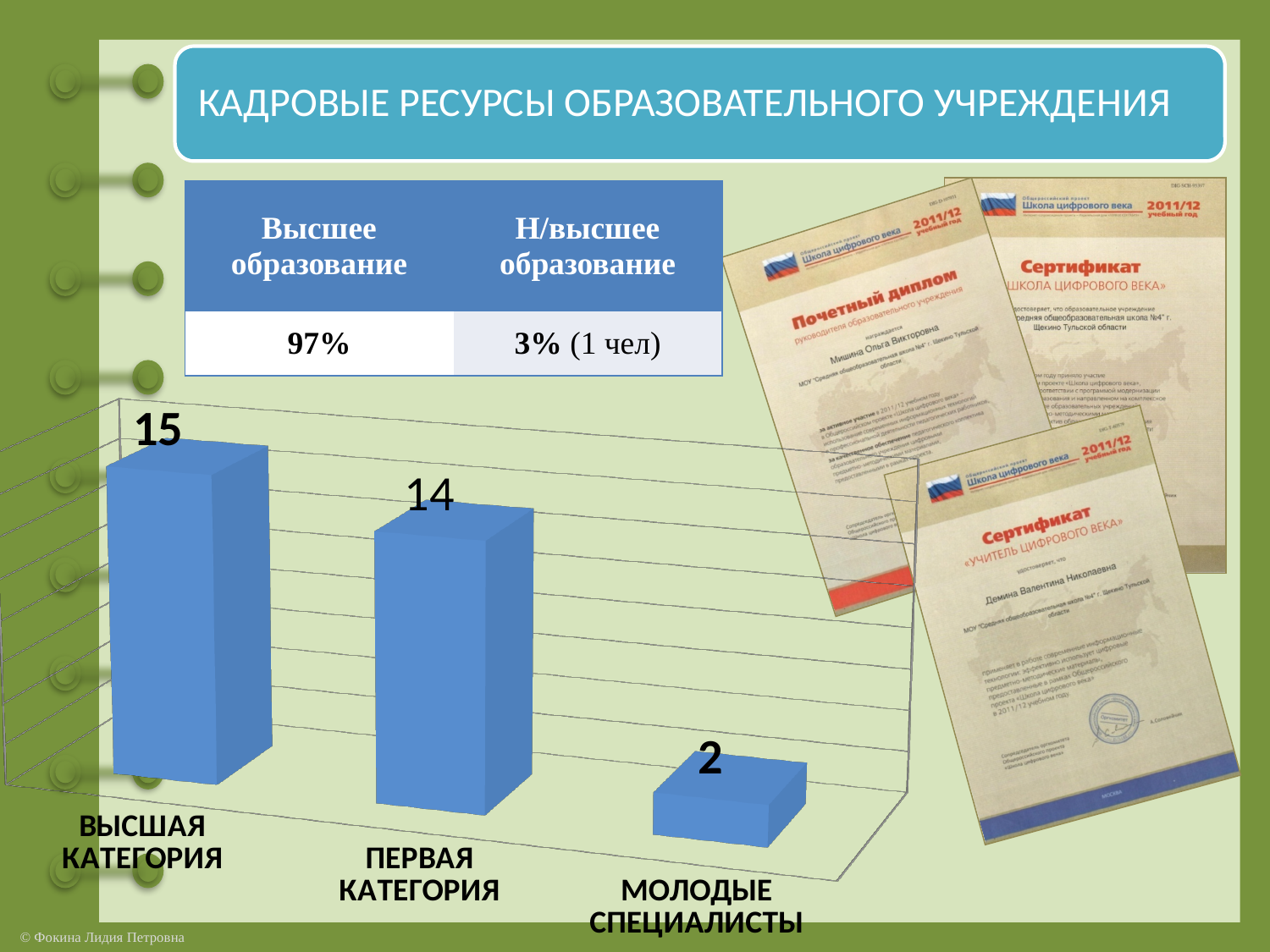
What colour are the bars in the chart? blue What kind of chart is shown on the slide? bar chart How many categories are shown in the chart? 3 Which is larger, the value for ПЕРВАЯ КАТЕГОРИЯ or the value for МОЛОДЫЕ СПЕЦИАЛИСТЫ? ПЕРВАЯ КАТЕГОРИЯ Do the values rise or fall from left to right across the categories? fall Which category has the highest value? ВЫСШАЯ КАТЕГОРИЯ Which category has the lowest value? МОЛОДЫЕ СПЕЦИАЛИСТЫ What is the value for ПЕРВАЯ КАТЕГОРИЯ? 14 What is the difference between the values for ВЫСШАЯ КАТЕГОРИЯ and ПЕРВАЯ КАТЕГОРИЯ? 1 What is the value for ВЫСШАЯ КАТЕГОРИЯ? 15 What is the difference between the values for ПЕРВАЯ КАТЕГОРИЯ and МОЛОДЫЕ СПЕЦИАЛИСТЫ? 12 What is the value for МОЛОДЫЕ СПЕЦИАЛИСТЫ? 2